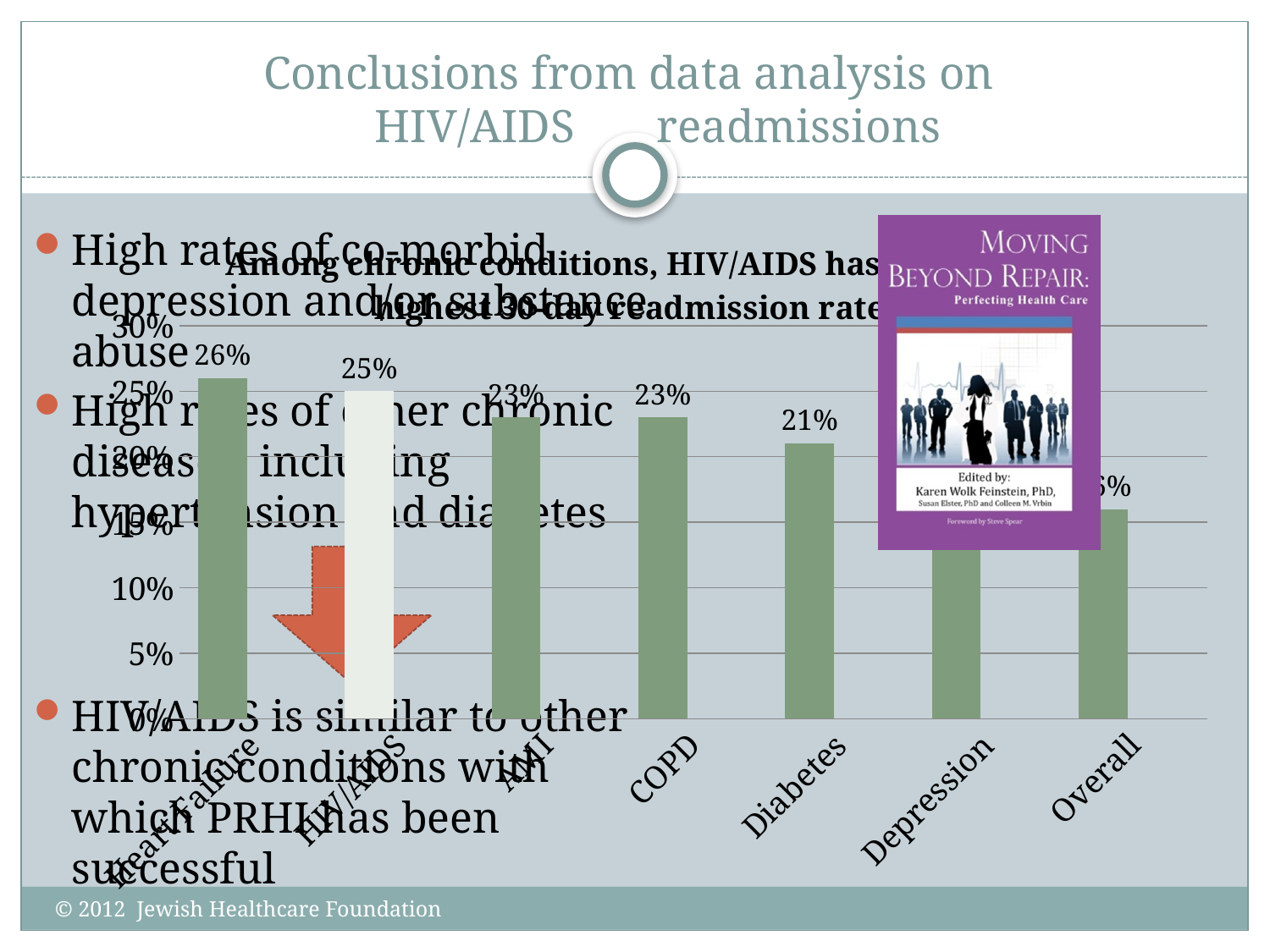
What is the difference between the values for Heart Failure and Diabetes? 5% What is the value shown for COPD? 23% What is the difference between the values for HIV/AIDS and COPD? 2% What is the 30-day readmission rate shown for Heart Failure? 26% What kind of chart is shown on the slide? bar chart Which category has the highest value in the chart? Heart Failure Which is larger, the value for AMI or the value for Diabetes? AMI Which category has the lowest bar in the chart? Overall What is the value shown for HIV/AIDS? 25% What is the value shown for Diabetes? 21% How many categories are shown on the x axis of the chart? 7